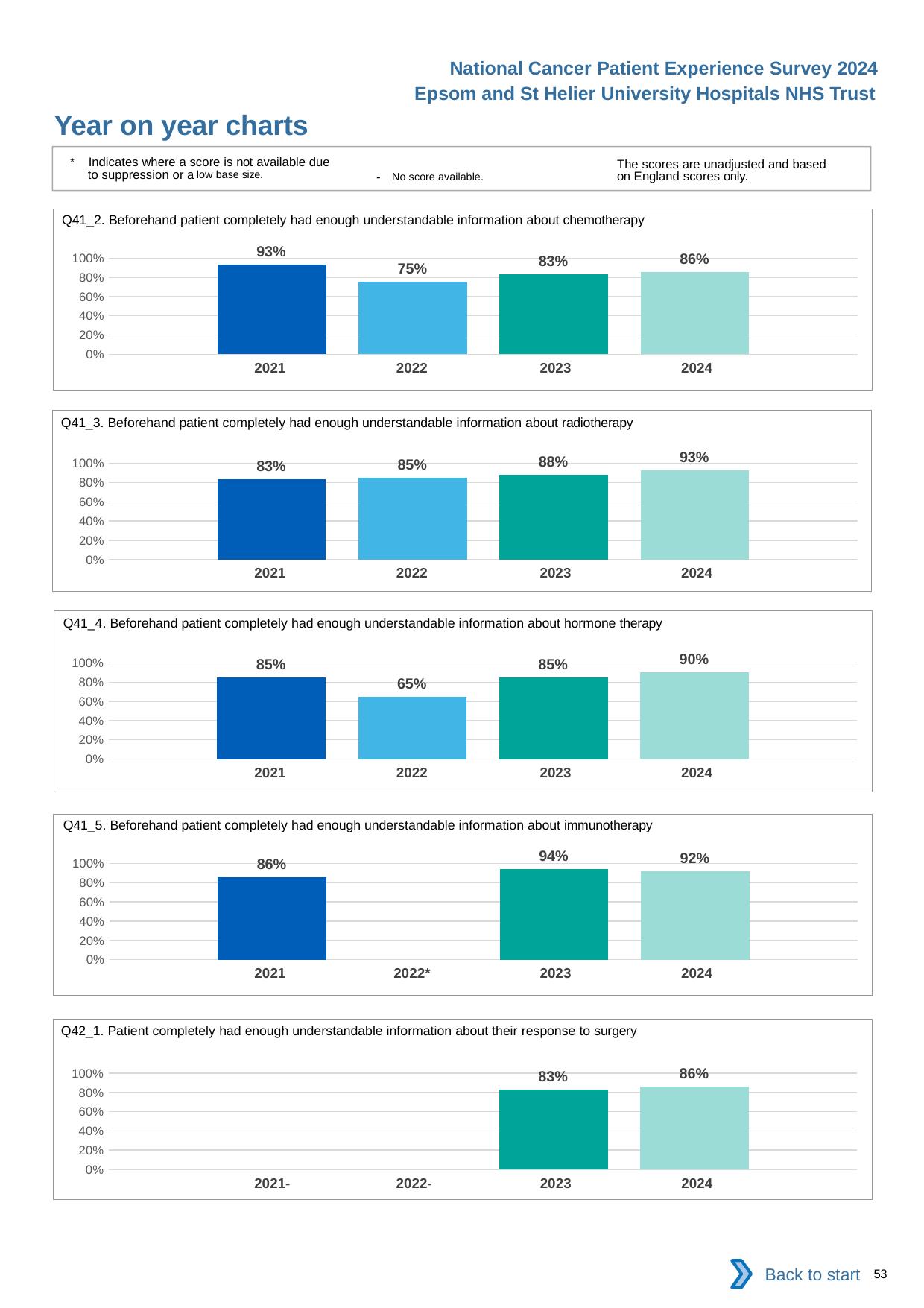
In the Q41_5 immunotherapy chart, which is larger, the value for 2023 or the value for 2024? 2023 In the Q41_5 immunotherapy chart, how many years have a bar plotted? 3 In the Q42_1 surgery chart, is the value for 2024 greater or less than 80%? greater In the Q41_3 radiotherapy chart, do the values rise or fall from 2021 to 2024? rise In the Q41_4 hormone therapy chart, what is the difference between the 2021 and 2022 values? 20% In the Q41_3 radiotherapy chart, what is the value for 2024? 93% In the Q41_2 chemotherapy chart, what is the value for 2022? 75% In the Q41_2 chemotherapy chart, which year has the highest value? 2021 What type of chart is the Q41_2 chemotherapy chart? bar chart In the Q41_3 radiotherapy chart, what is the difference between the 2024 and 2021 values? 10% In the Q42_1 surgery chart, what is the value for 2023? 83% In the Q41_4 hormone therapy chart, which year has the lowest value? 2022